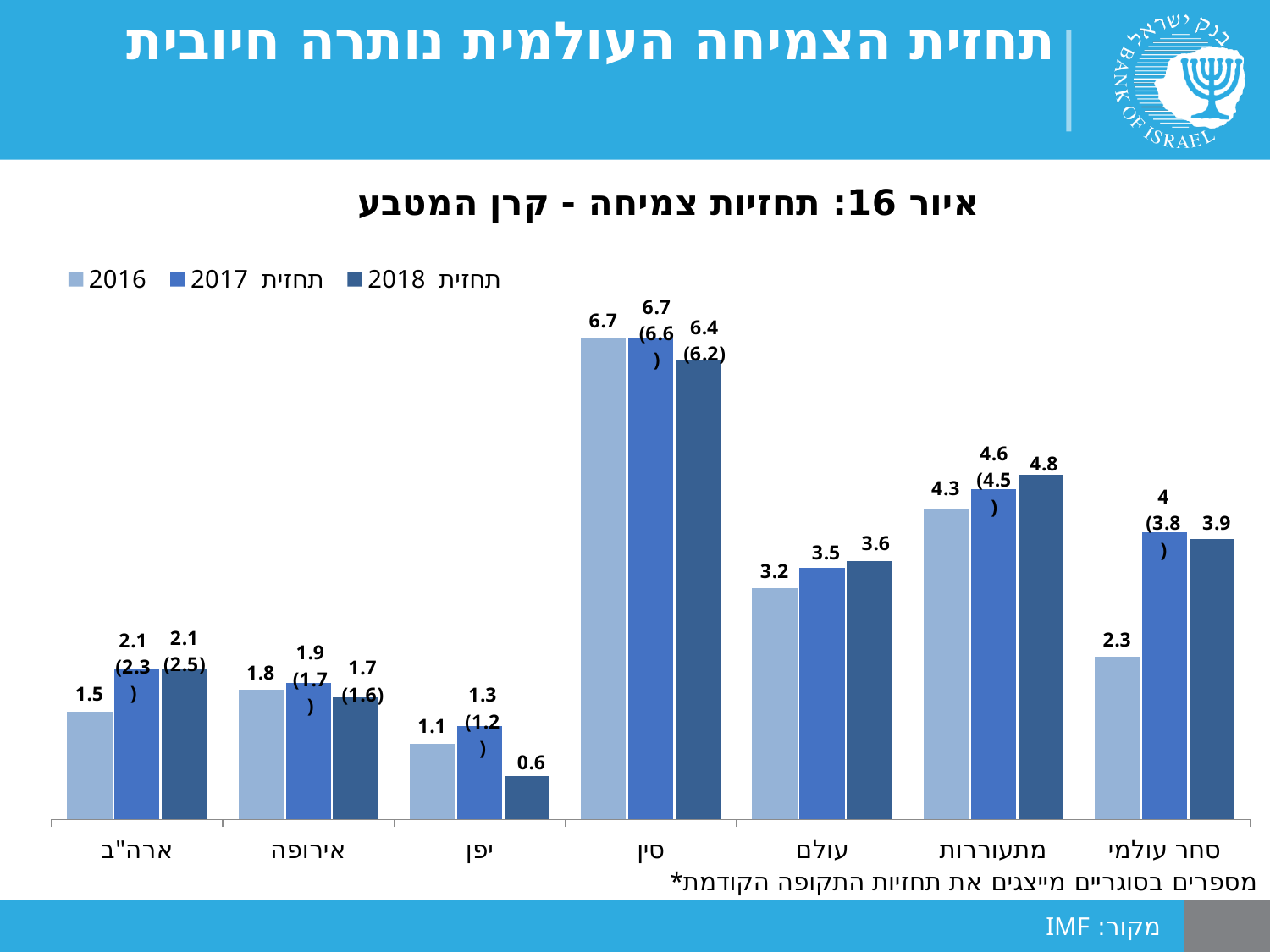
What is the תחזית 2017 (2017 forecast) value for עולם (World)? 3.5 Which category has the lowest תחזית 2018 (2018 forecast) value? יפן (Japan) What is the 2016 value for סין (China)? 6.7 What kind of chart is shown? Bar chart What is the 2016 value for סחר עולמי (World trade)? 2.3 Which category has the highest 2016 value? סין (China) What is the difference between the תחזית 2018 and 2016 values for מתעוררות (Emerging)? 0.5 How many series does the legend list? 3 Do the values for עולם (World) rise or fall from 2016 to תחזית 2018? Rise How many categories are shown on the x axis? 7 Which is larger for אירופה (Europe): the 2016 value or the תחזית 2018 value? 2016 What is the תחזית 2018 (2018 forecast) value for יפן (Japan)? 0.6